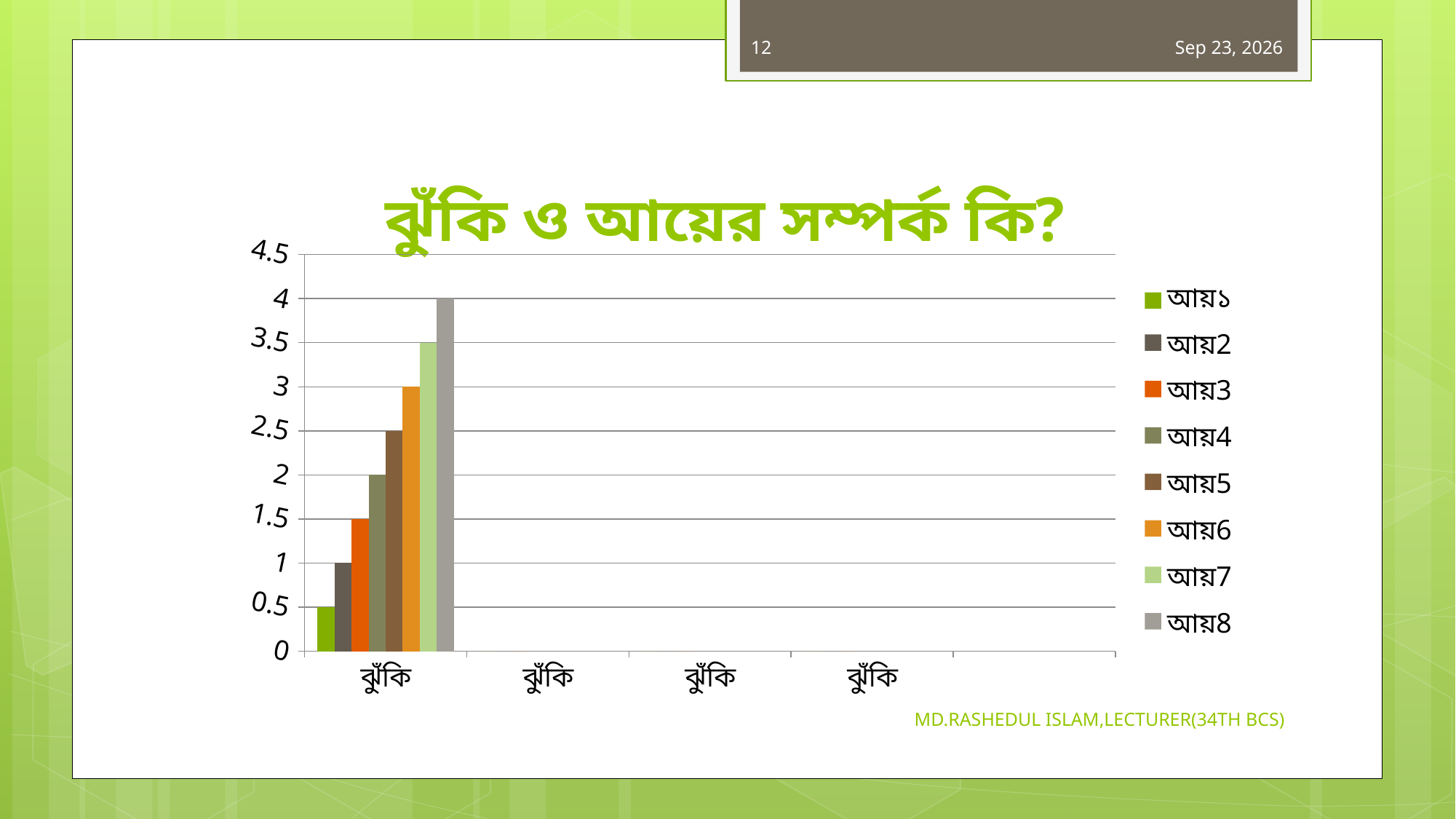
What is the value of the আয়5 bar in the first ঝুঁকি category? 2.5 What is the difference between the আয়8 bar and the আয়1 bar in the first ঝুঁকি category? 3.5 Do the bar values rise or fall from আয়1 to আয়8 in the first ঝুঁকি category? rise What kind of chart is shown on the slide? bar chart Which is larger in the first ঝুঁকি category, the আয়6 bar or the আয়4 bar? আয়6 What is the title of the chart? ঝুঁকি ও আয়ের সম্পর্ক কি? How many series does the legend list? 8 Which series has the highest bar in the first ঝুঁকি category? আয়8 What is the value of the আয়8 bar in the first ঝুঁকি category? 4 Which series has the lowest bar in the first ঝুঁকি category? আয়1 What is the value of the আয়3 bar in the first ঝুঁকি category? 1.5 What is the value of the আয়1 bar in the first ঝুঁকি category? 0.5